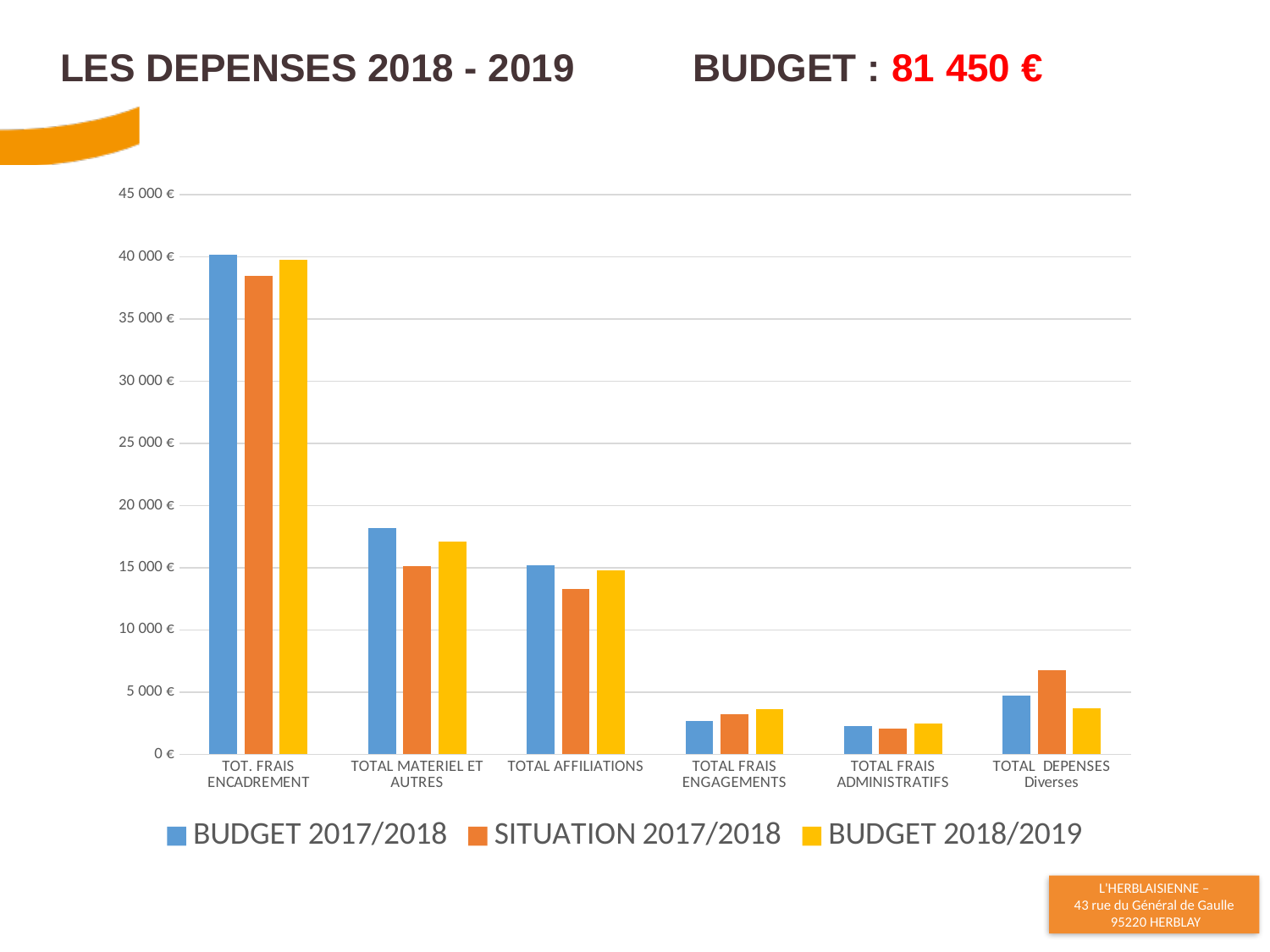
Is the BUDGET 2018/2019 value for TOTAL AFFILIATIONS greater or less than 10 000 €? greater For TOTAL MATERIEL ET AUTRES, which is larger: BUDGET 2017/2018 or SITUATION 2017/2018? BUDGET 2017/2018 Is the BUDGET 2017/2018 value for TOT. FRAIS ENCADREMENT greater or less than 35 000 €? greater What kind of chart is shown on the slide? bar chart What total budget figure is shown in red at the top of the slide? 81 450 € How many series does the legend list? 3 How many categories are shown on the x axis? 6 Is the SITUATION 2017/2018 value for TOTAL MATERIEL ET AUTRES greater or less than 20 000 €? less Which category has the highest BUDGET 2018/2019 value? TOT. FRAIS ENCADREMENT Which category has the lowest BUDGET 2018/2019 value? TOTAL FRAIS ADMINISTRATIFS For TOTAL DEPENSES Diverses, which is larger: SITUATION 2017/2018 or BUDGET 2018/2019? SITUATION 2017/2018 Which series has the highest value for TOTAL FRAIS ENGAGEMENTS? BUDGET 2018/2019